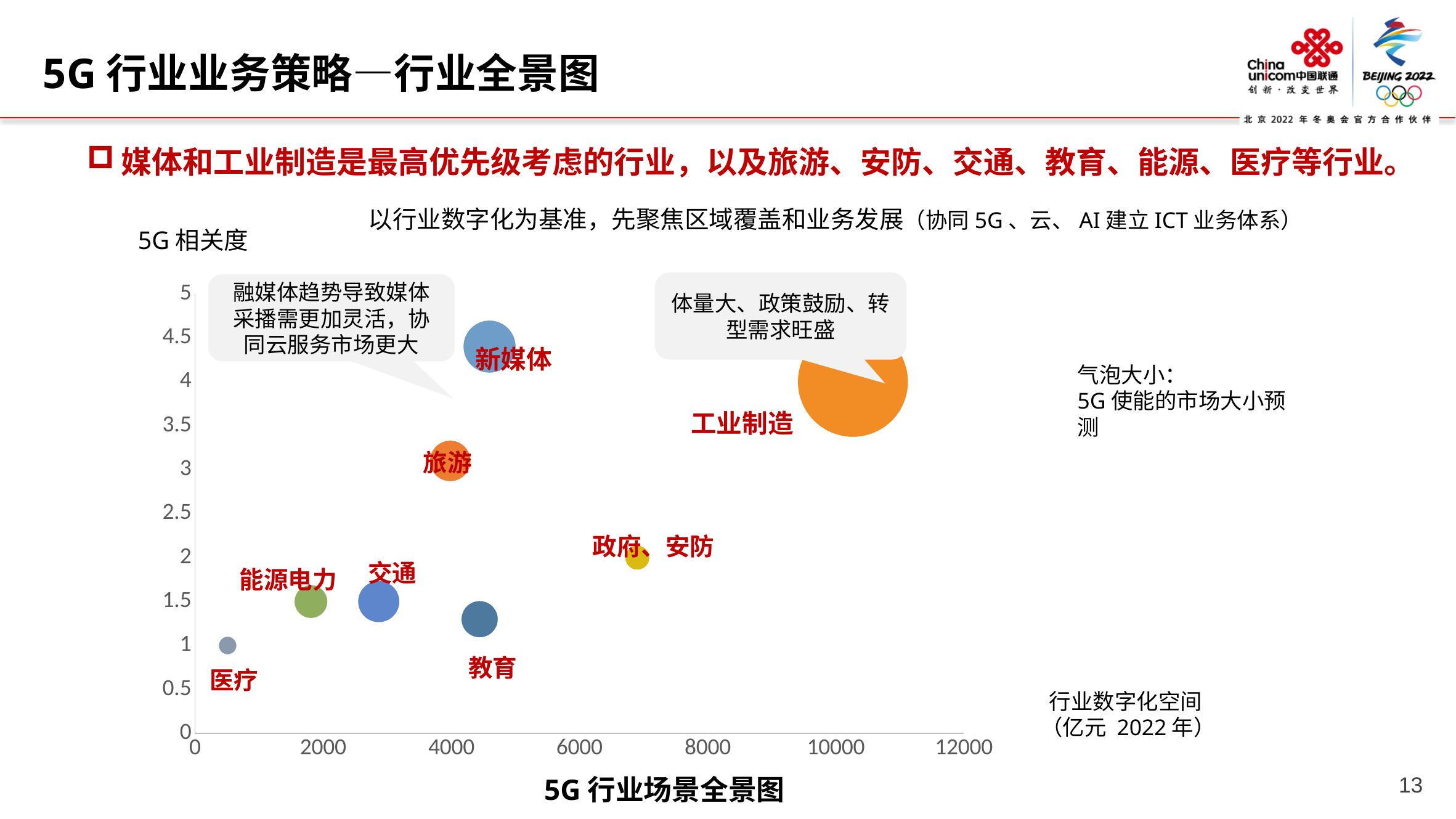
What kind of chart is shown on the slide? Bubble chart Is the 行业数字化空间 value for 医疗 greater or less than 2000? less What is the title of the chart? 5G 行业场景全景图 Which industry has the largest 行业数字化空间 (x-axis value) in the chart? 工业制造 How many industry bubbles are plotted in the chart? 8 Which industry has the highest 5G 相关度 (y-axis value) in the chart? 新媒体 Is the 行业数字化空间 value for 工业制造 greater or less than 8000? greater Which industry has the lowest 5G 相关度 (y-axis value) in the chart? 医疗 Is the 5G 相关度 value for 工业制造 greater or less than 3? greater Which industry has the largest bubble in the chart? 工业制造 Which has a larger 行业数字化空间 (x-axis value), 政府、安防 or 交通? 政府、安防 Which has a higher 5G 相关度, 新媒体 or 旅游? 新媒体